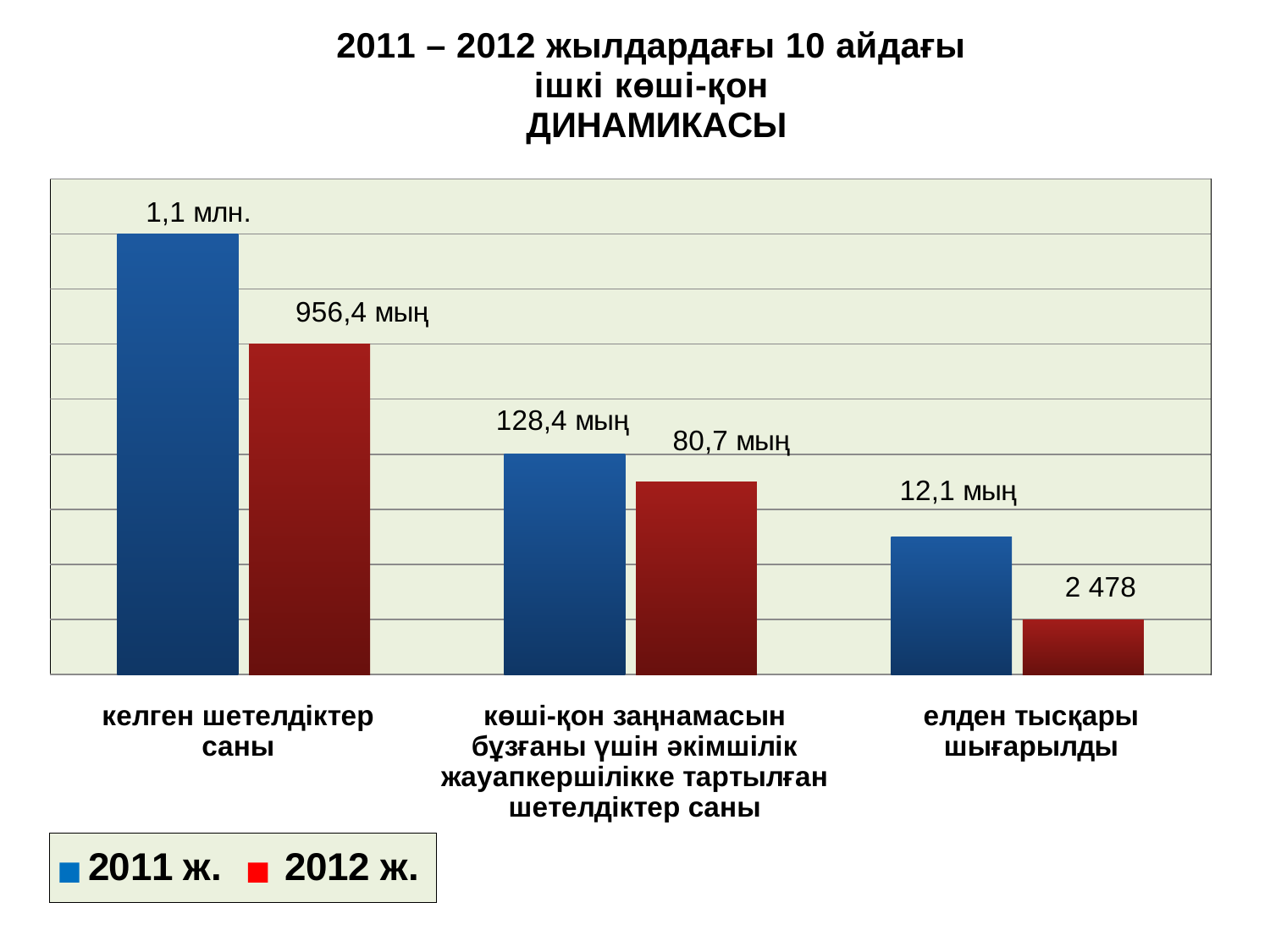
What is the value for 2012 ж. in the category 'елден тысқары шығарылды'? 2 478 How many categories are shown on the x axis? 3 What is the value for 2011 ж. in the category 'келген шетелдіктер саны'? 1,1 млн. Which category has the lowest value for 2012 ж.? елден тысқары шығарылды Which series is larger in the category 'елден тысқары шығарылды', 2011 ж. or 2012 ж.? 2011 ж. What type of chart is shown on the slide? bar chart What is the value for 2011 ж. in the category 'көші-қон заңнамасын бұзғаны үшін әкімшілік жауапкершілікке тартылған шетелдіктер саны'? 128,4 мың How many series does the legend list? 2 What is the value for 2012 ж. in the category 'келген шетелдіктер саны'? 956,4 мың Which category has the highest value for 2011 ж.? келген шетелдіктер саны What is the value for 2011 ж. in the category 'елден тысқары шығарылды'? 12,1 мың What is the difference between the 2011 ж. and 2012 ж. values in the category 'көші-қон заңнамасын бұзғаны үшін әкімшілік жауапкершілікке тартылған шетелдіктер саны'? 47,7 мың